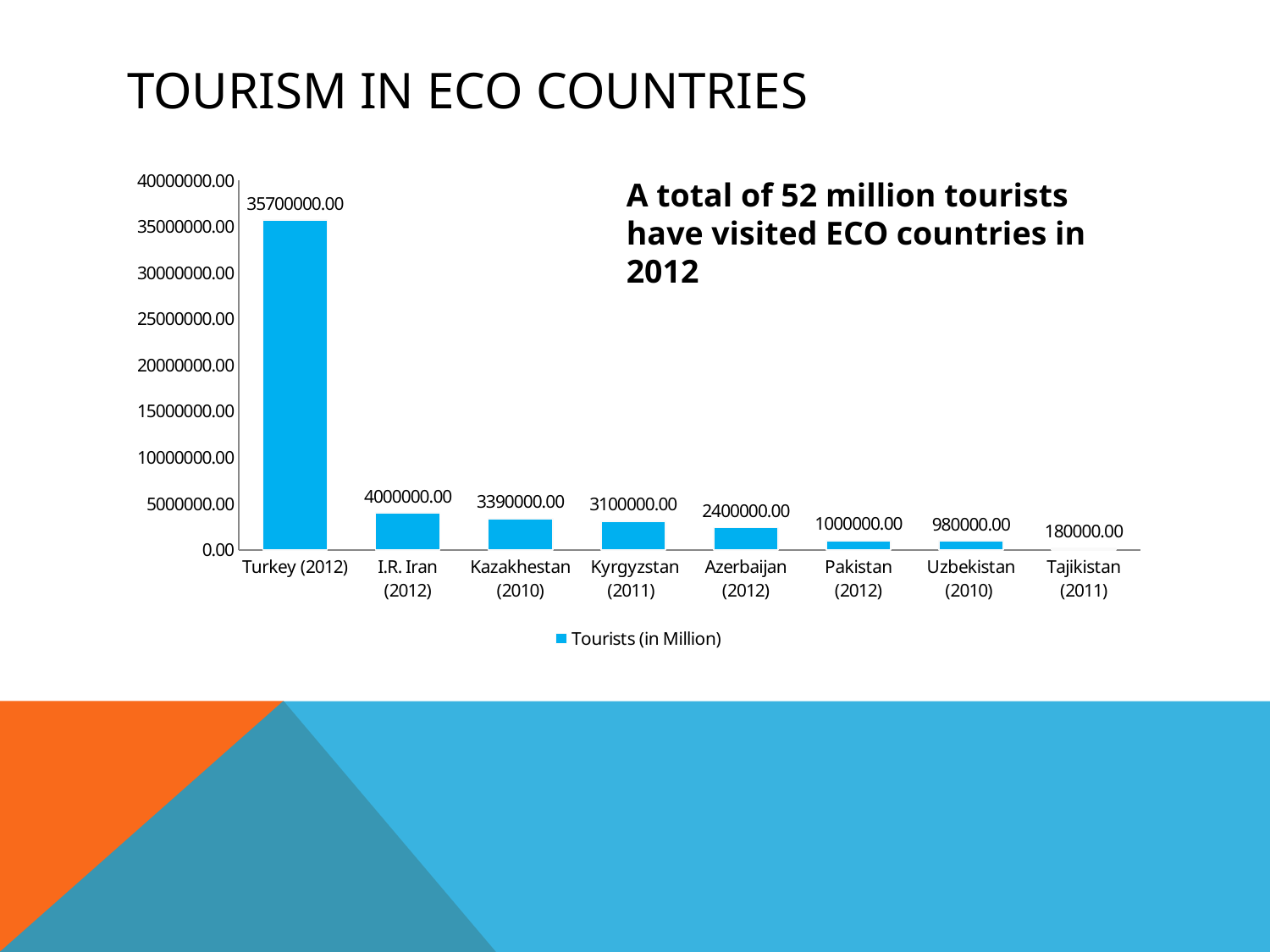
What is the value for Tajikistan (2011)? 180000.00 What kind of chart is shown on the slide? bar chart How many countries are shown on the chart? 8 Which country has the highest number of tourists? Turkey (2012) Which is larger, the value for Azerbaijan (2012) or the value for Pakistan (2012)? Azerbaijan (2012) What is the difference between the values for I.R. Iran (2012) and Kyrgyzstan (2011)? 900000.00 Is the value for Turkey (2012) greater or less than 30000000.00? greater Which country has the lowest number of tourists? Tajikistan (2011) What is the value for Turkey (2012)? 35700000.00 What is the value for Kazakhestan (2010)? 3390000.00 How many series does the legend list? 1 What is the legend entry for the series shown? Tourists (in Million)